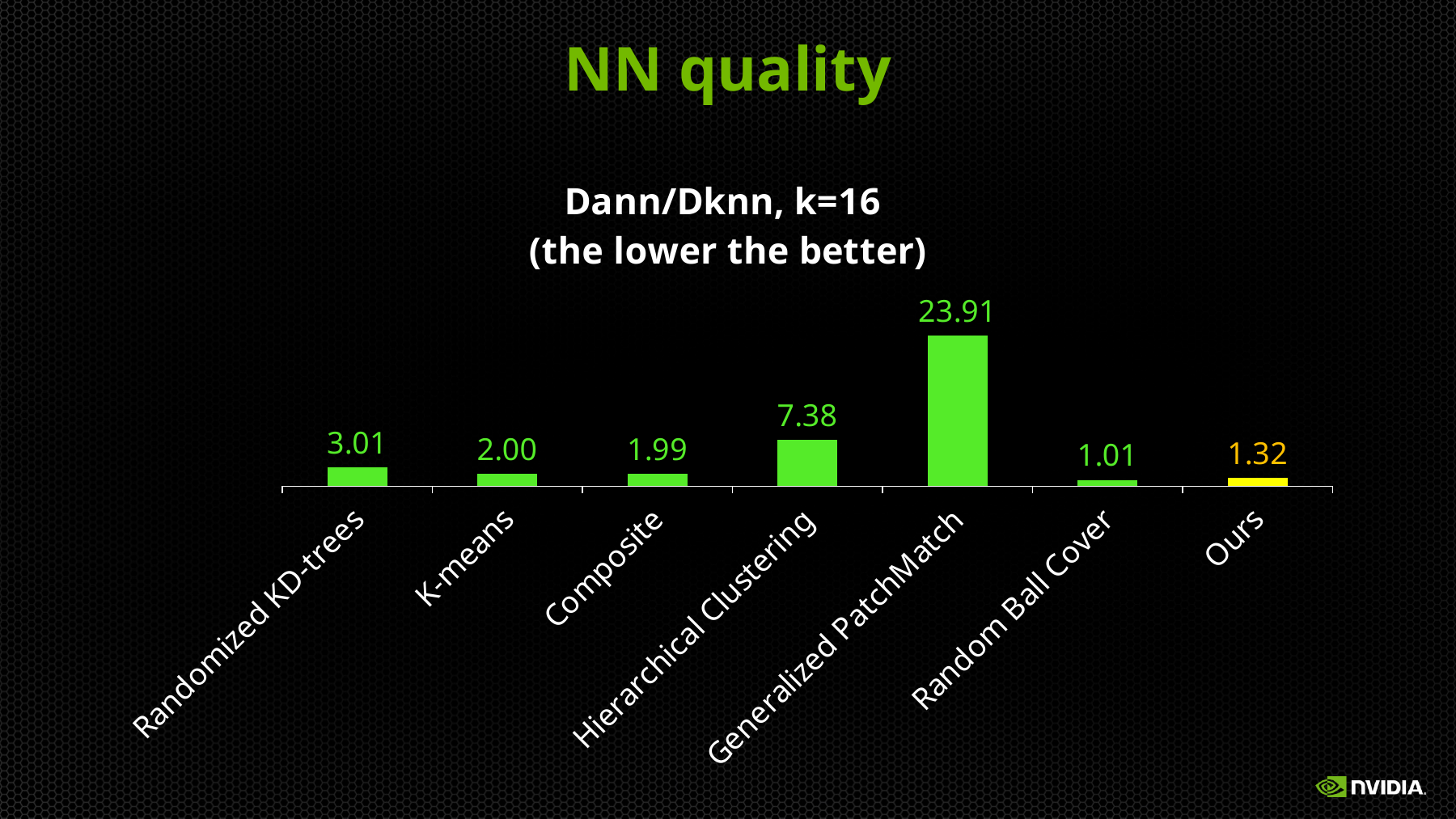
What is the difference between the Dann/Dknn values of Randomized KD-trees and K-means? 1.01 Which has a larger Dann/Dknn value, Randomized KD-trees or Ours? Randomized KD-trees What is the Dann/Dknn value for Random Ball Cover? 1.01 Which method has the lowest Dann/Dknn value? Random Ball Cover What is the difference between the Dann/Dknn values of Generalized PatchMatch and Hierarchical Clustering? 16.53 What is the Dann/Dknn value for Ours? 1.32 What is the Dann/Dknn value for Hierarchical Clustering? 7.38 What kind of chart is shown on the slide? Bar chart Which method has the highest Dann/Dknn value? Generalized PatchMatch How many methods are shown on the chart? 7 What is the title of the chart? Dann/Dknn, k=16 (the lower the better) What is the Dann/Dknn value for Generalized PatchMatch? 23.91